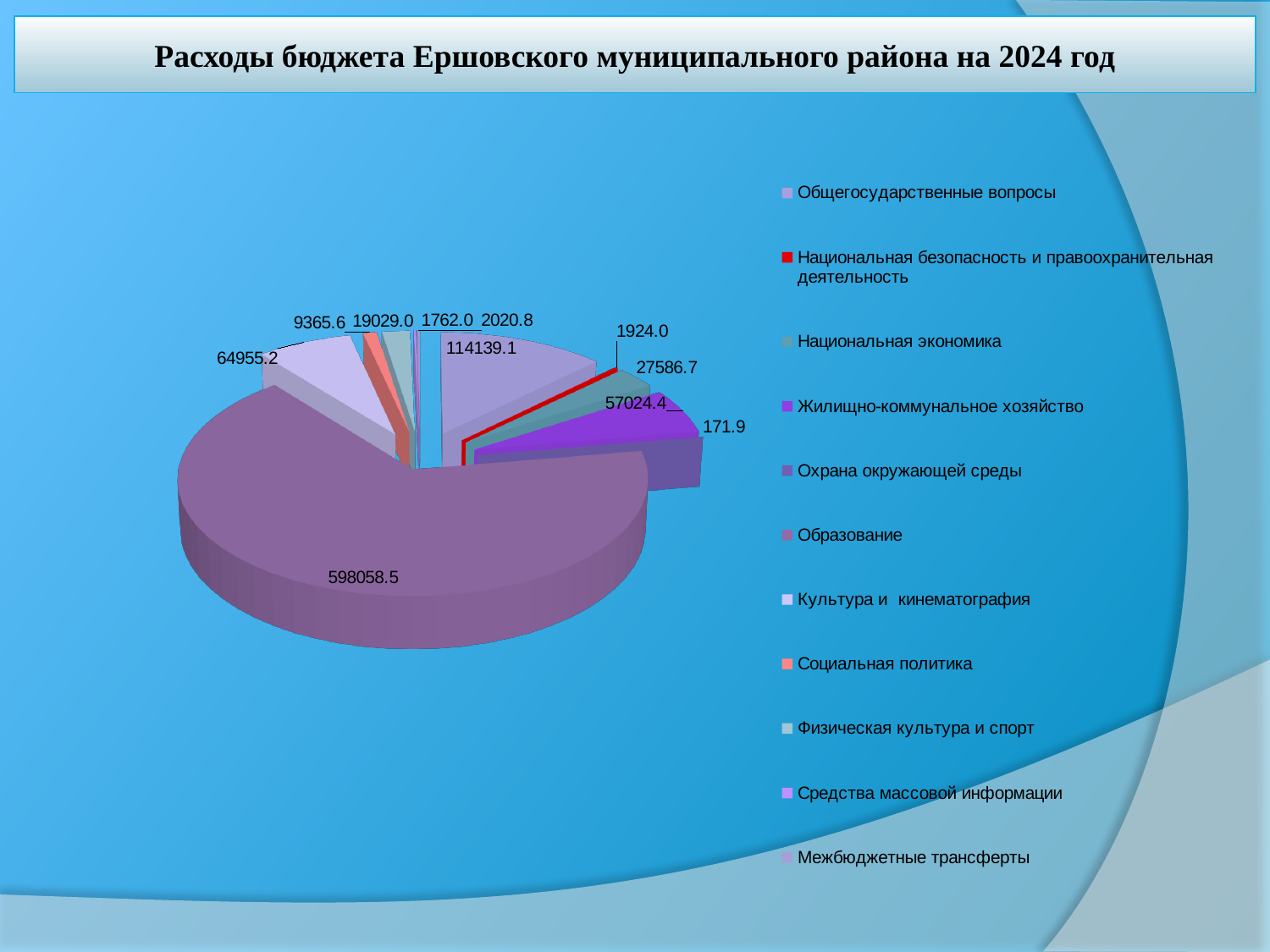
What kind of chart is shown on the slide? Pie chart What is the value shown for Образование? 598058.5 What is the value shown for Охрана окружающей среды? 171.9 What is the title of the chart on the slide? Расходы бюджета Ершовского муниципального района на 2024 год How many categories does the legend of the pie chart list? 11 Which is larger, the value for Национальная экономика or the value for Физическая культура и спорт? Национальная экономика Which is larger, the value for Культура и кинематография or the value for Жилищно-коммунальное хозяйство? Культура и кинематография Which category has the largest slice of the pie? Образование What is the difference between the values for Образование and Общегосударственные вопросы? 483919.4 What is the value shown for Общегосударственные вопросы? 114139.1 Which category has the smallest slice of the pie? Охрана окружающей среды What is the value shown for Жилищно-коммунальное хозяйство? 57024.4